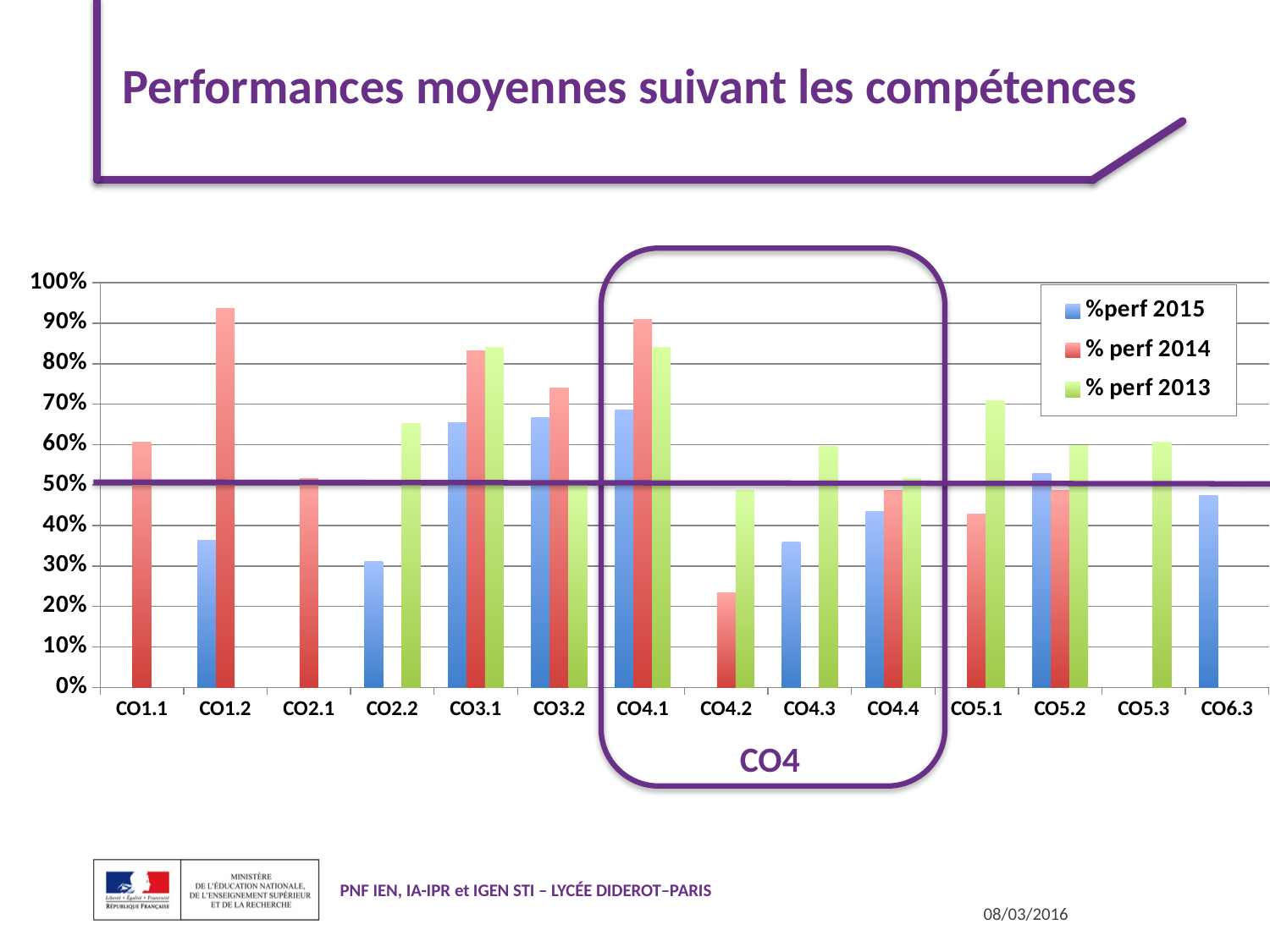
How many series does the legend list? 3 Is the % perf 2013 value for CO5.1 greater or less than 60%? greater What is the title of the chart on the slide? Performances moyennes suivant les compétences Which category has the lowest value for the % perf 2014 series? CO4.2 Which category has the highest value for the %perf 2015 series? CO4.1 Which category has the highest value for the % perf 2014 series? CO1.2 What kind of chart is shown on the slide? bar chart How many categories are shown on the x axis? 14 For CO4.3, which series has the larger value: %perf 2015 or % perf 2013? % perf 2013 Is the % perf 2014 value for CO1.1 greater or less than 50%? greater Is the % perf 2014 value for CO4.2 greater or less than 30%? less Which category has the lowest value for the %perf 2015 series? CO2.2